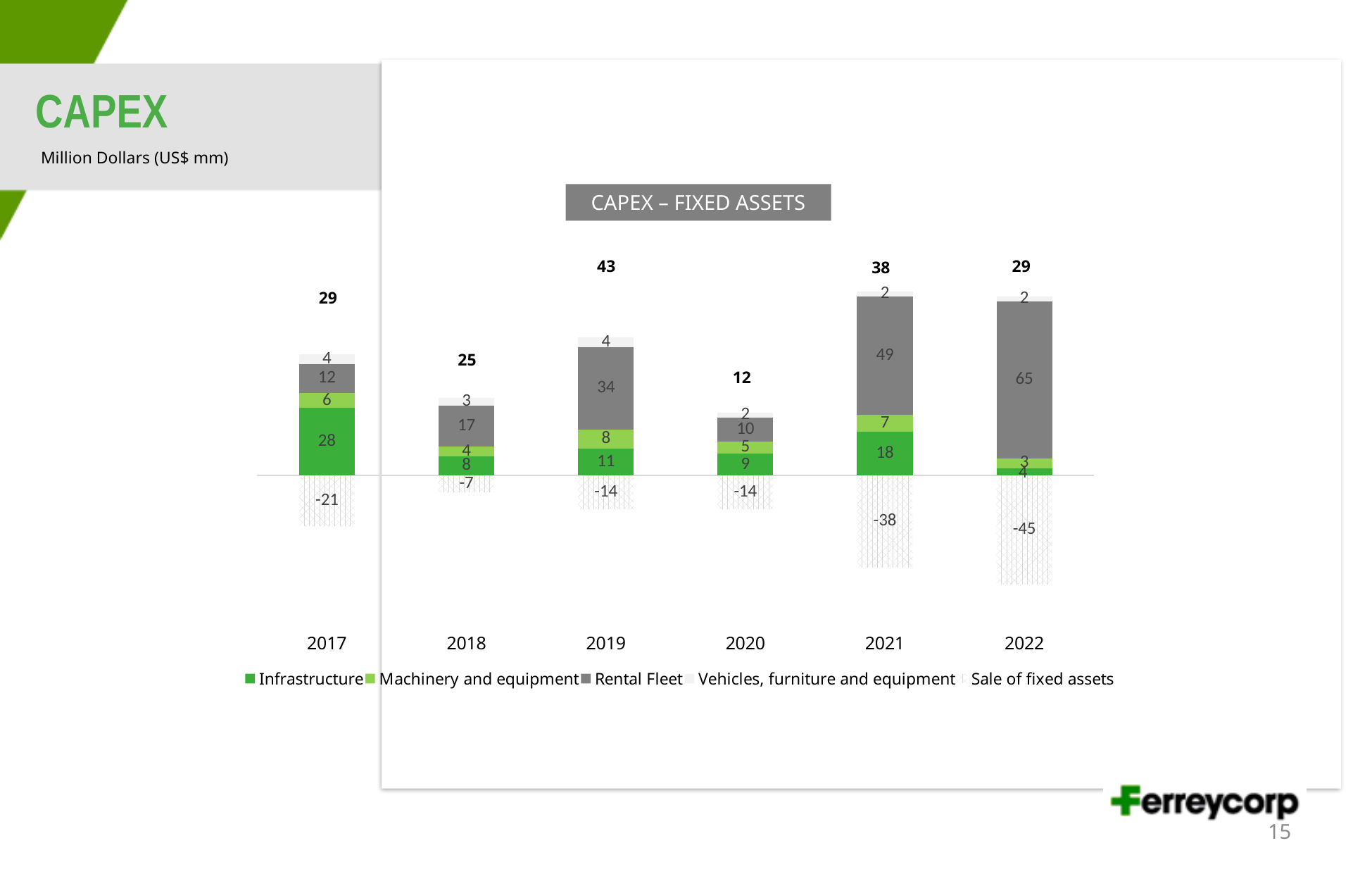
What is the difference between the Rental Fleet values for 2021 and 2019? 15 Which year has the lowest total shown above its bar? 2020 How many years are shown on the x axis? 6 What is the Sale of fixed assets value for 2021? -38 What is the Machinery and equipment value for 2019? 8 Which year has the highest total shown above its bar? 2019 What is the Rental Fleet value for 2022? 65 Which is larger, the Infrastructure value for 2021 or for 2020? 2021 What is the title of the chart? CAPEX – FIXED ASSETS What kind of chart is shown on the slide? Stacked bar chart How many series does the legend list? 5 What is the Infrastructure value for 2017? 28